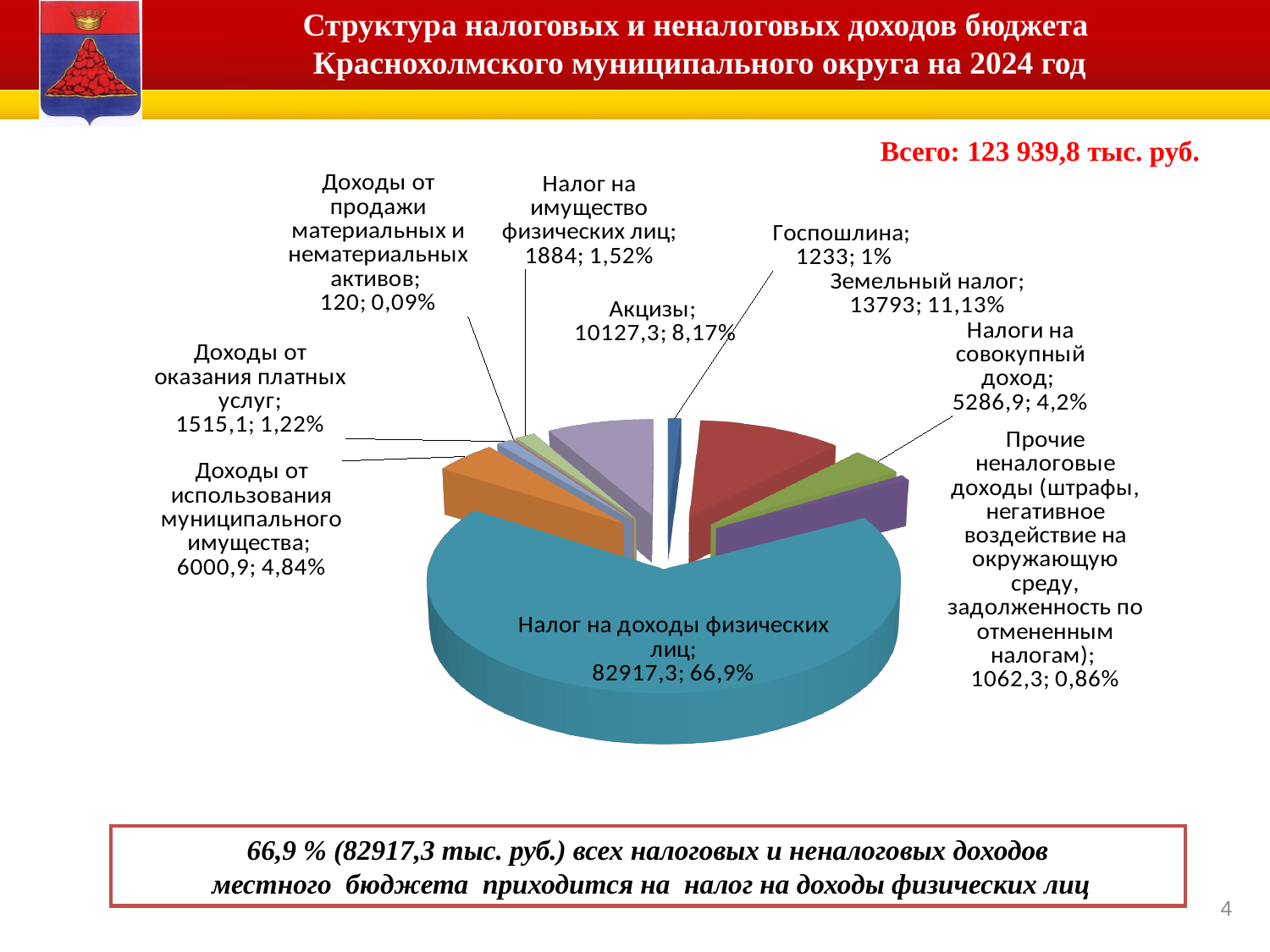
What share of the pie does Налог на доходы физических лиц represent? 66,9% What is the value for Земельный налог? 13793 What is the value for Акцизы? 10127,3 How many categories (slices) does the pie chart show? 10 What kind of chart is shown on the slide? pie chart Which category has the largest value? Налог на доходы физических лиц What share of the pie does Налоги на совокупный доход represent? 4,2% What is the value for Доходы от использования муниципального имущества? 6000,9 What total amount (Всего) is stated on the slide? 123 939,8 тыс. руб. Which is larger: the value for Госпошлина or the value for Налог на имущество физических лиц? Налог на имущество физических лиц What is the difference between the values for Земельный налог and Акцизы? 3665,7 Which category has the smallest value? Доходы от продажи материальных и нематериальных активов